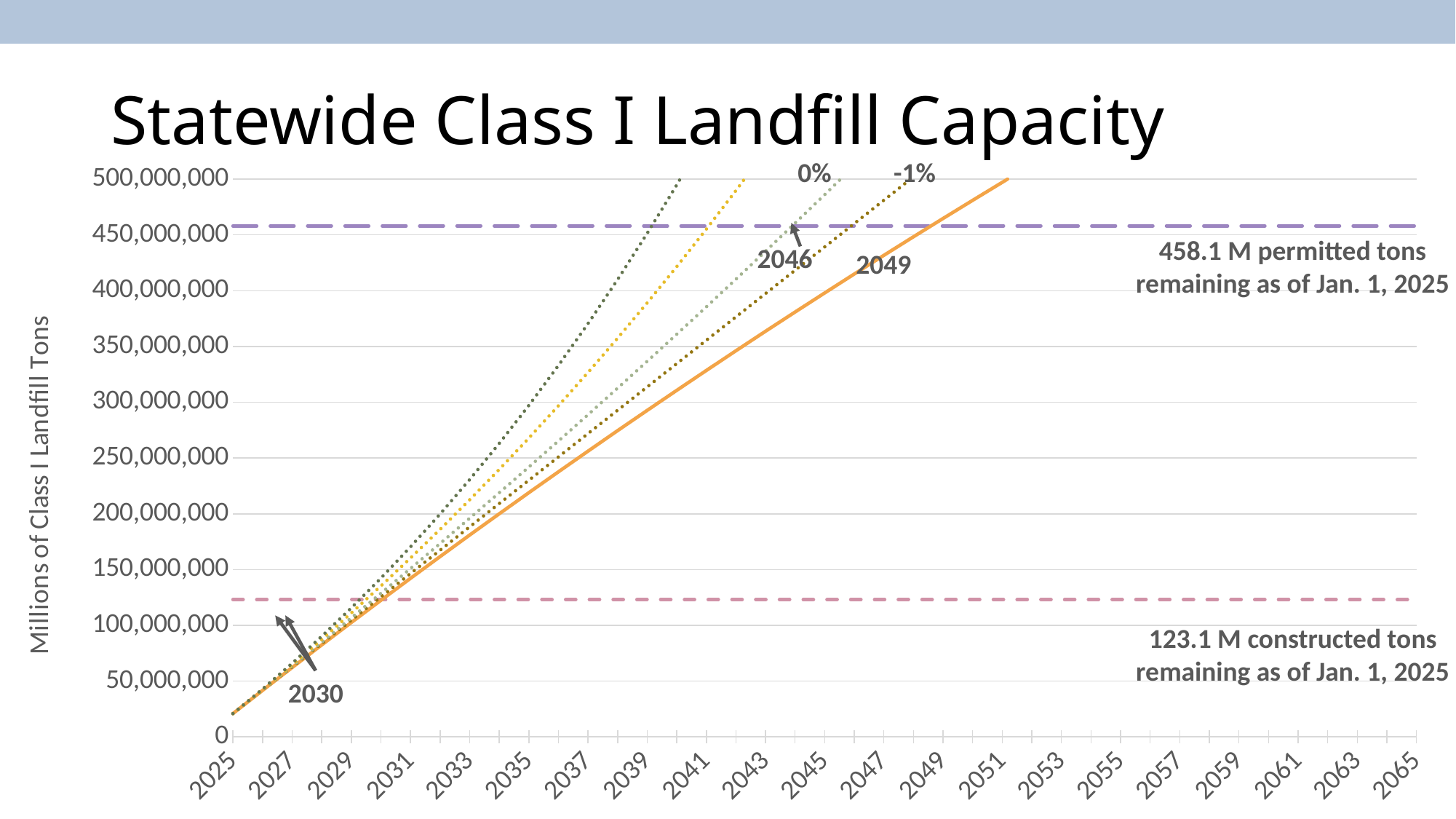
What is the difference between the permitted tons remaining (458.1 M) and the constructed tons remaining (123.1 M)? 335.0 M How many constructed tons were remaining as of Jan. 1, 2025, according to the lower dashed line annotation? 123.1 M Is the permitted tons remaining value (458.1 M) greater or less than 450,000,000 on the vertical axis? greater What is the title of the chart? Statewide Class I Landfill Capacity In what year does the 0% scenario line reach the permitted-capacity dashed line, according to the annotation on the chart? 2046 Do the plotted projection lines rise or fall as the years increase along the x axis? rise Which is larger: the permitted tons remaining or the constructed tons remaining as of Jan. 1, 2025? permitted tons remaining How many permitted tons were remaining as of Jan. 1, 2025, according to the upper dashed line annotation? 458.1 M In what year does the -1% scenario line reach the permitted-capacity dashed line, according to the annotation on the chart? 2049 What type of chart is shown on the slide? line chart In what year do the projection lines cross the constructed-capacity dashed line, according to the annotation on the chart? 2030 What is the label on the vertical axis of the chart? Millions of Class I Landfill Tons